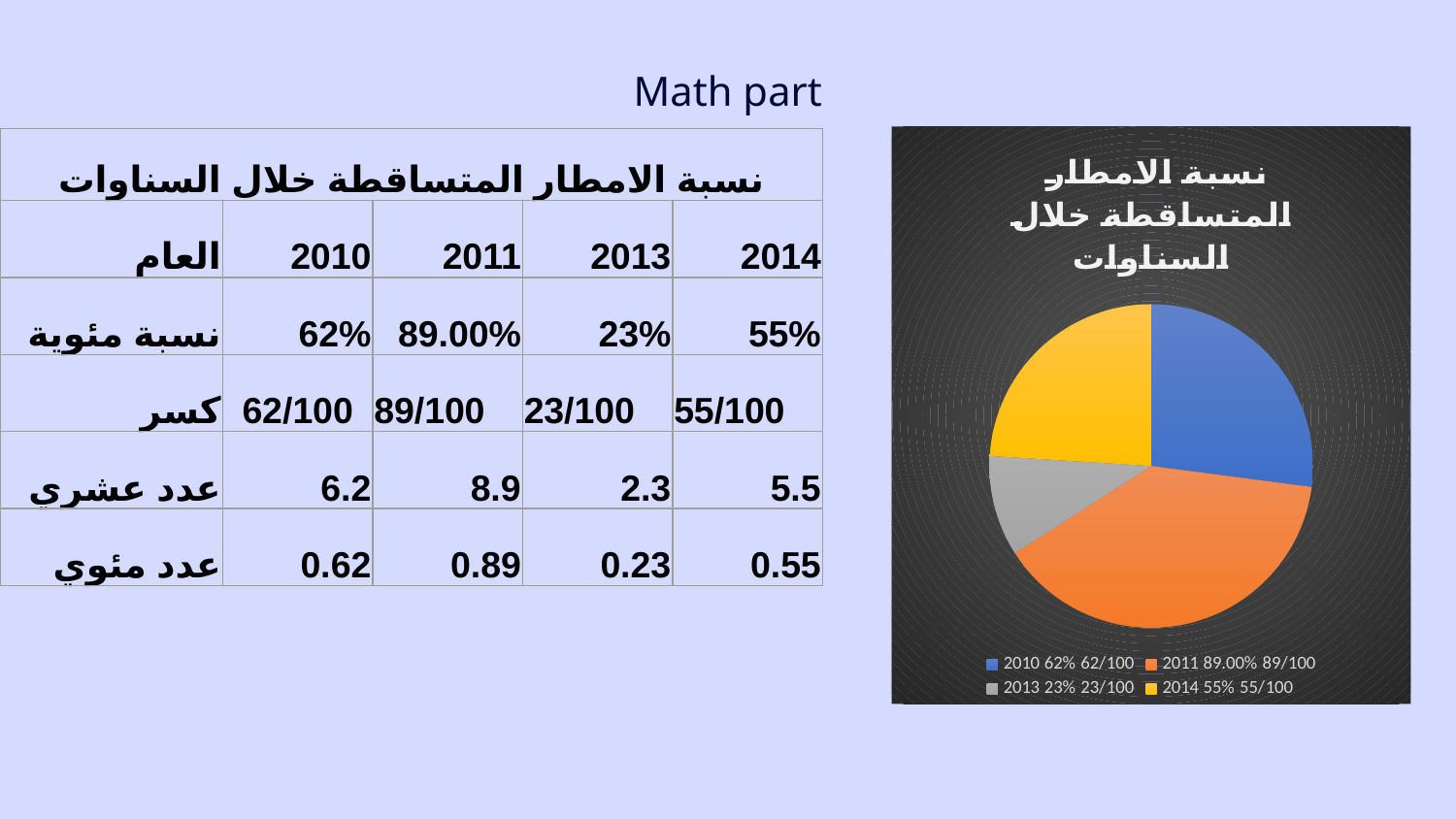
In the pie chart, which slice is larger, 2011 or 2013? 2011 What is the difference between the percentages shown for 2011 and 2013 in the pie chart's legend? 66% What colour is the slice for 2010 in the pie chart? blue How many slices does the pie chart have? 4 According to the pie chart's legend, what percentage is given for 2011? 89.00% According to the pie chart's legend, what percentage is given for 2013? 23% What kind of chart is shown on the slide? pie chart How many entries does the pie chart's legend list? 4 Which year has the smallest slice in the pie chart? 2013 Which year has the largest slice in the pie chart? 2011 What colour is the slice for 2014 in the pie chart? yellow According to the pie chart's legend, what fraction is given for 2014? 55/100